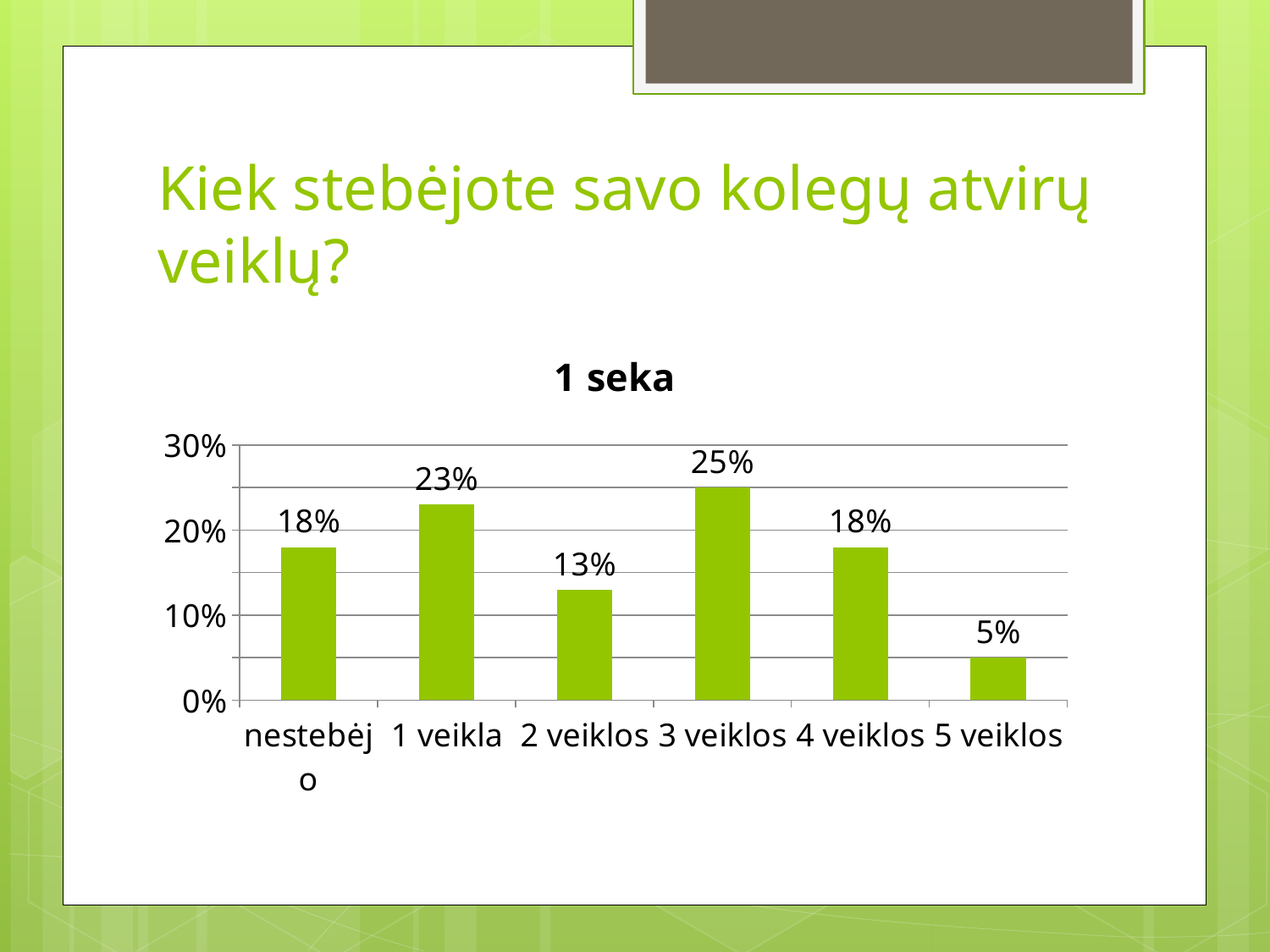
What is the title of the chart? 1 seka Which category has the highest value? 3 veiklos How many categories are shown on the x axis? 6 What is the value for "5 veiklos"? 5% Is the value for "2 veiklos" greater or less than 20%? less What is the difference between the values for "1 veikla" and "2 veiklos"? 10% What is the value for "3 veiklos"? 25% What is the value for "nestebėjo"? 18% What kind of chart is shown on the slide? bar chart Which is larger, the value for "1 veikla" or the value for "4 veiklos"? 1 veikla Which category has the lowest value? 5 veiklos What is the value for "2 veiklos"? 13%